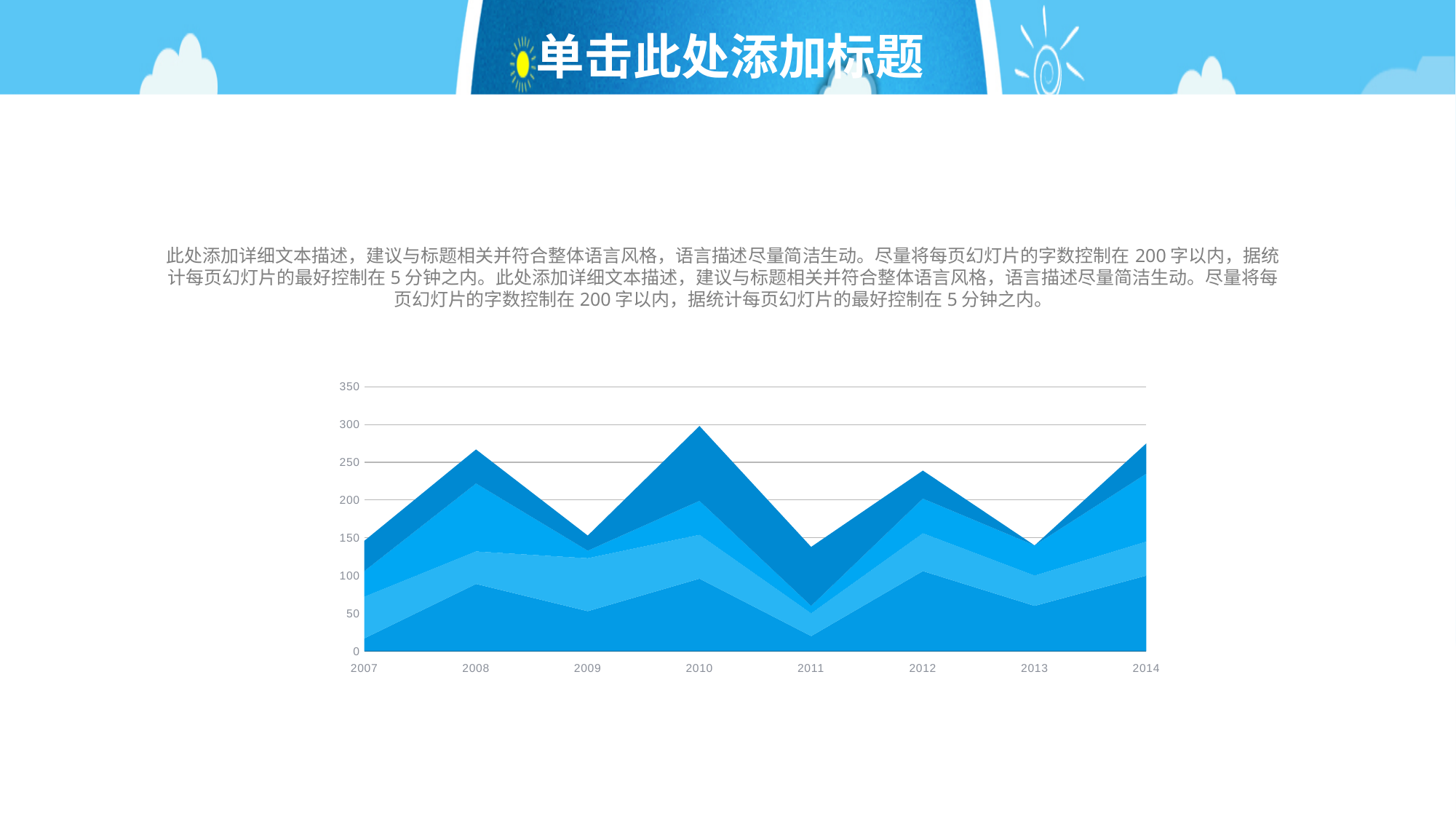
Is the total value for 2008 greater or less than 250? greater Is the total value for 2014 greater or less than 250? greater Is the total value for 2011 greater or less than 200? less Which year has the larger total value, 2010 or 2011? 2010 Which year has the larger total value, 2008 or 2009? 2008 What kind of chart is shown on the slide? Area chart How many years are shown along the x axis of the chart? 8 What is the highest value shown on the chart's y axis? 350 Does the total value rise or fall from 2011 to 2012? rise Which year has the highest total (top of the stacked area) in the chart? 2010